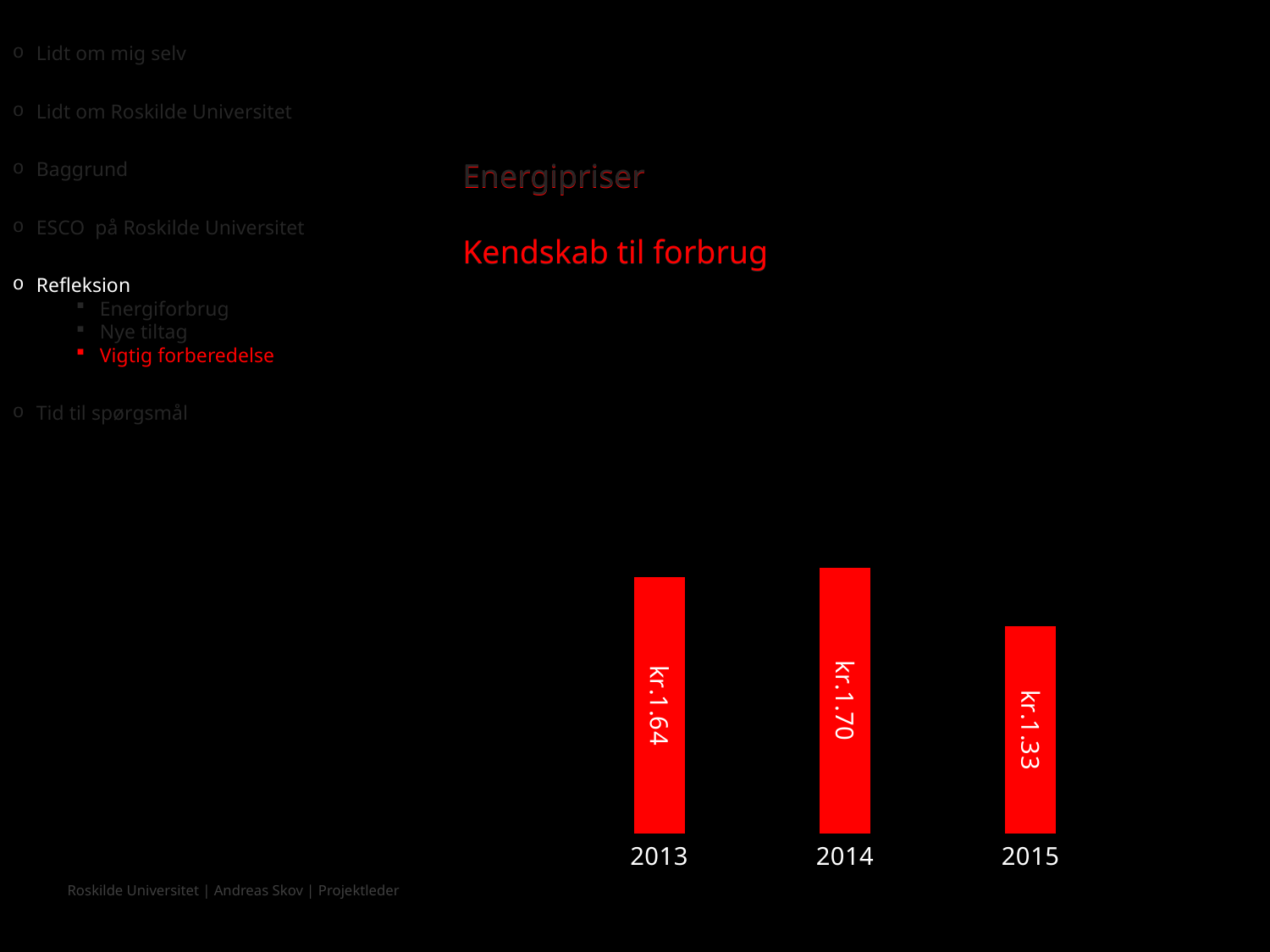
What is the difference between the values for 2014 and 2015? kr.0.37 Which year has the highest value? 2014 What is the value shown for 2014? kr.1.70 Does the value rise or fall from 2014 to 2015? fall Which year has the lowest value? 2015 What colour are the bars in the chart? red What kind of chart is shown on the slide? bar chart What is the difference between the values for 2013 and 2015? kr.0.31 How many years are shown in the chart? 3 What is the value shown for 2015? kr.1.33 What is the value shown for 2013? kr.1.64 Which is larger, the value for 2013 or the value for 2015? 2013